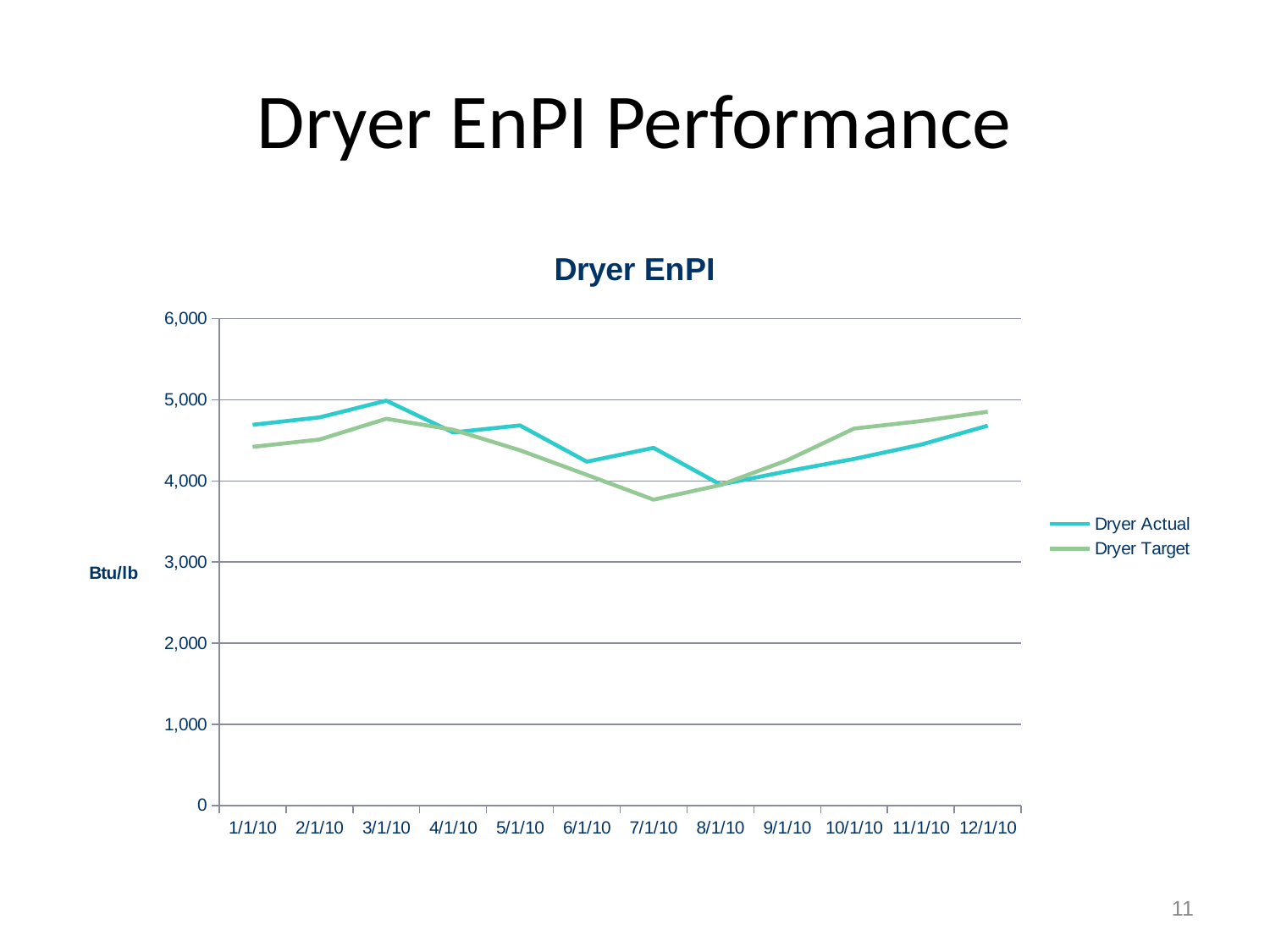
Is the Dryer Actual value for 6/1/10 greater or less than 4,000? greater How many dates are plotted along the x axis? 12 Is the Dryer Target value for 7/1/10 greater or less than 4,000? less How many series does the legend list? 2 What kind of chart is shown on the slide? line chart What unit is shown on the vertical axis label of the chart? Btu/lb On 10/1/10, which series has the higher value, Dryer Actual or Dryer Target? Dryer Target On which date does the Dryer Actual series reach its highest value? 3/1/10 On which date does the Dryer Actual series reach its lowest value? 8/1/10 Is the Dryer Actual value for 1/1/10 greater or less than 5,000? less On which date does the Dryer Target series reach its lowest value? 7/1/10 On 1/1/10, which series has the higher value, Dryer Actual or Dryer Target? Dryer Actual